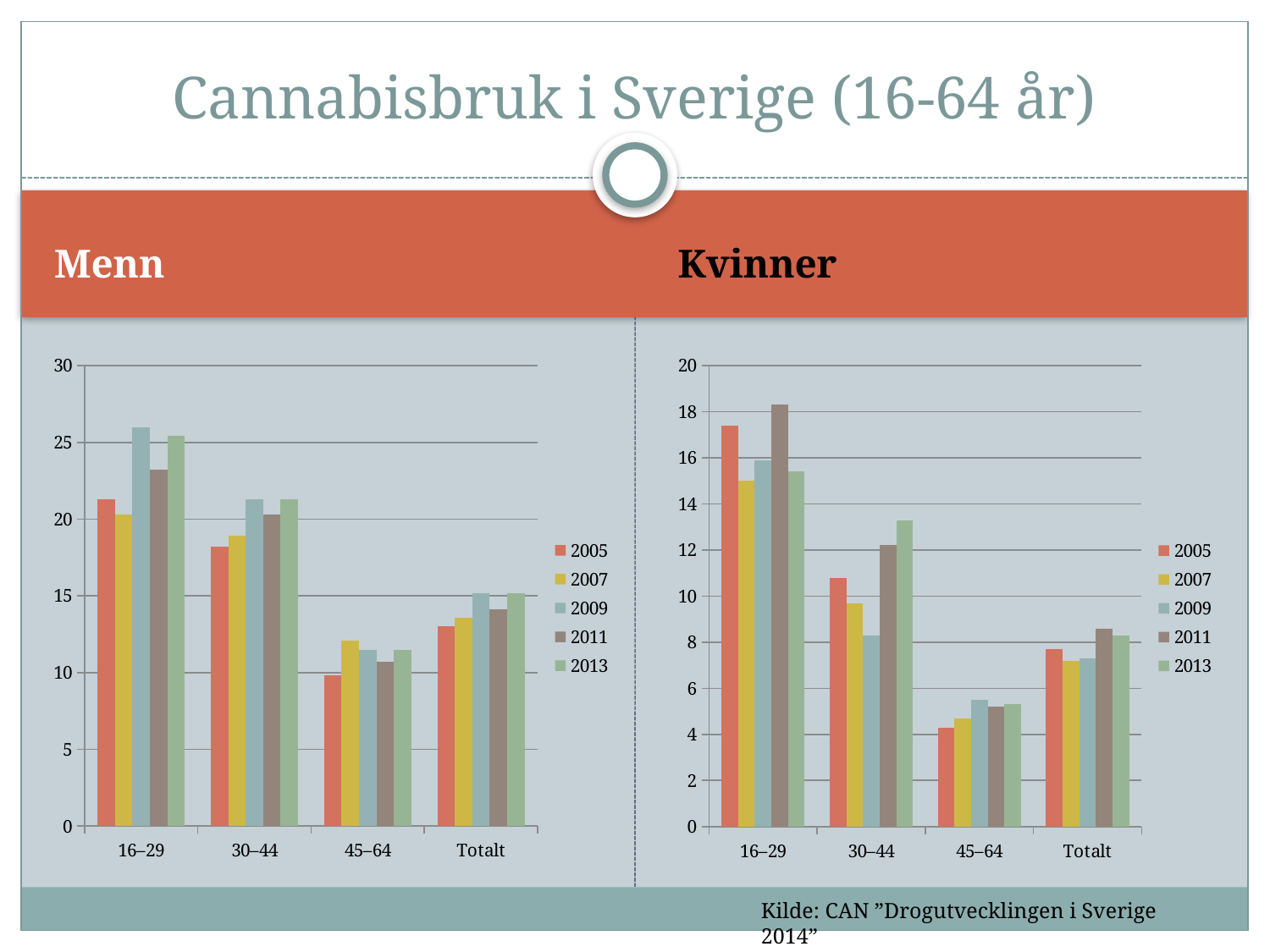
In the Menn chart, which age group has the highest bar for 2009? 16–29 In the Kvinner chart, which age group has the lowest bar for 2005? 45–64 In the Menn chart, is the 2009 value for 16–29 greater or less than 25? greater In the Kvinner chart, which is larger for 30–44: the 2005 value or the 2013 value? 2013 In the Menn chart, is the 2007 value for 45–64 greater or less than 10? greater How many categories are shown on the x axis of the Menn chart? 4 In the Menn chart, which is larger for Totalt: the 2005 value or the 2009 value? 2009 What are the legend entries of the Menn chart? 2005, 2007, 2009, 2011, 2013 What kind of chart is the Menn chart on the left? bar chart In the Kvinner chart, which year has the highest bar for 16–29? 2011 How many series does the legend of the Kvinner chart list? 5 In the Kvinner chart, is the 2011 value for 16–29 greater or less than 16? greater